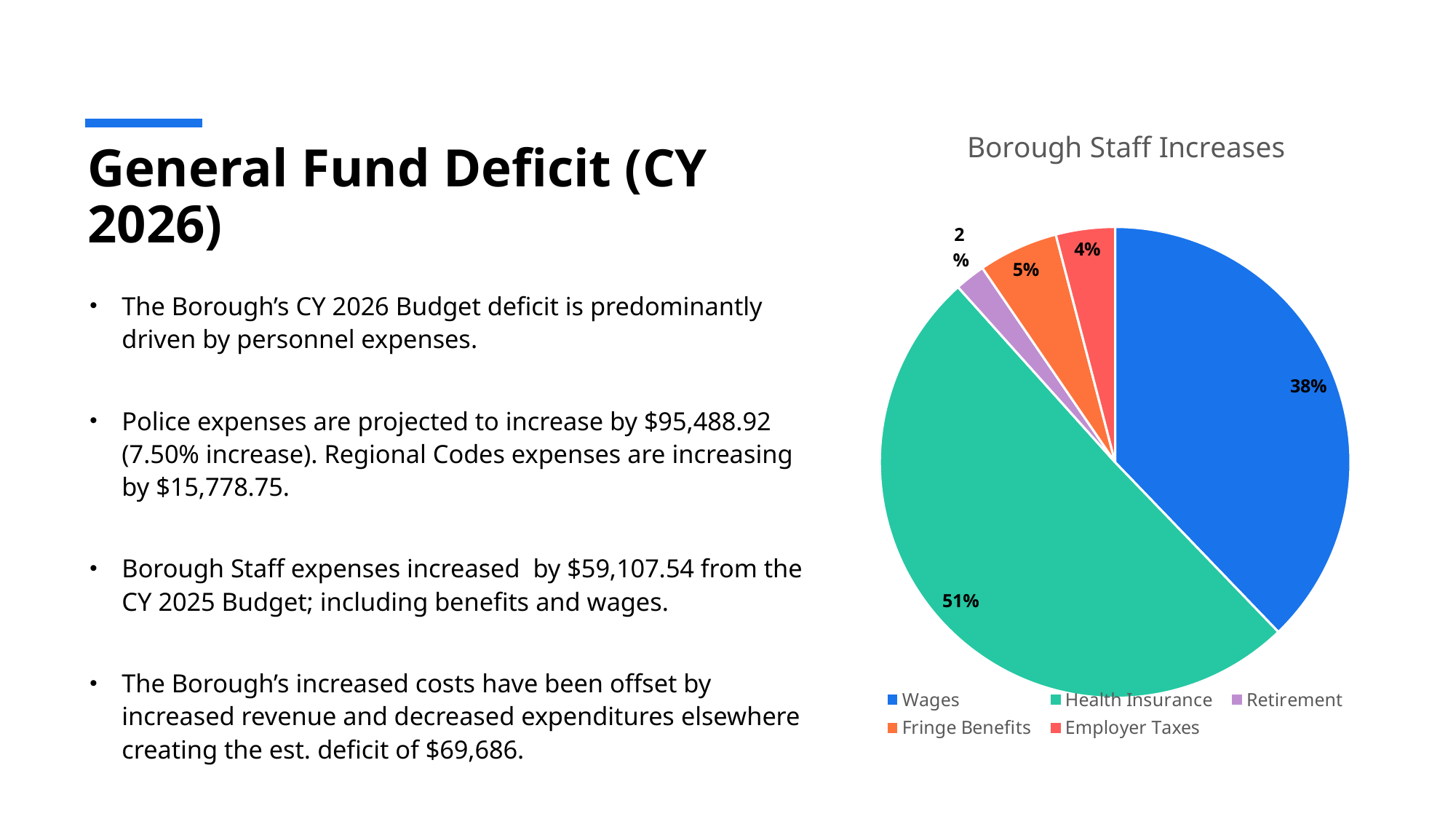
What is the title of the chart? Borough Staff Increases What share of the pie does Wages represent? 38% Which category has the largest slice of the pie? Health Insurance What type of chart is shown on the slide? pie chart How many categories does the pie chart show? 5 What is the difference in percentage points between the Health Insurance and Wages slices? 13 Which category has the smallest slice of the pie? Retirement What share of the pie does Employer Taxes represent? 4% What share of the pie does Fringe Benefits represent? 5% Which is larger, the Fringe Benefits slice or the Employer Taxes slice? Fringe Benefits